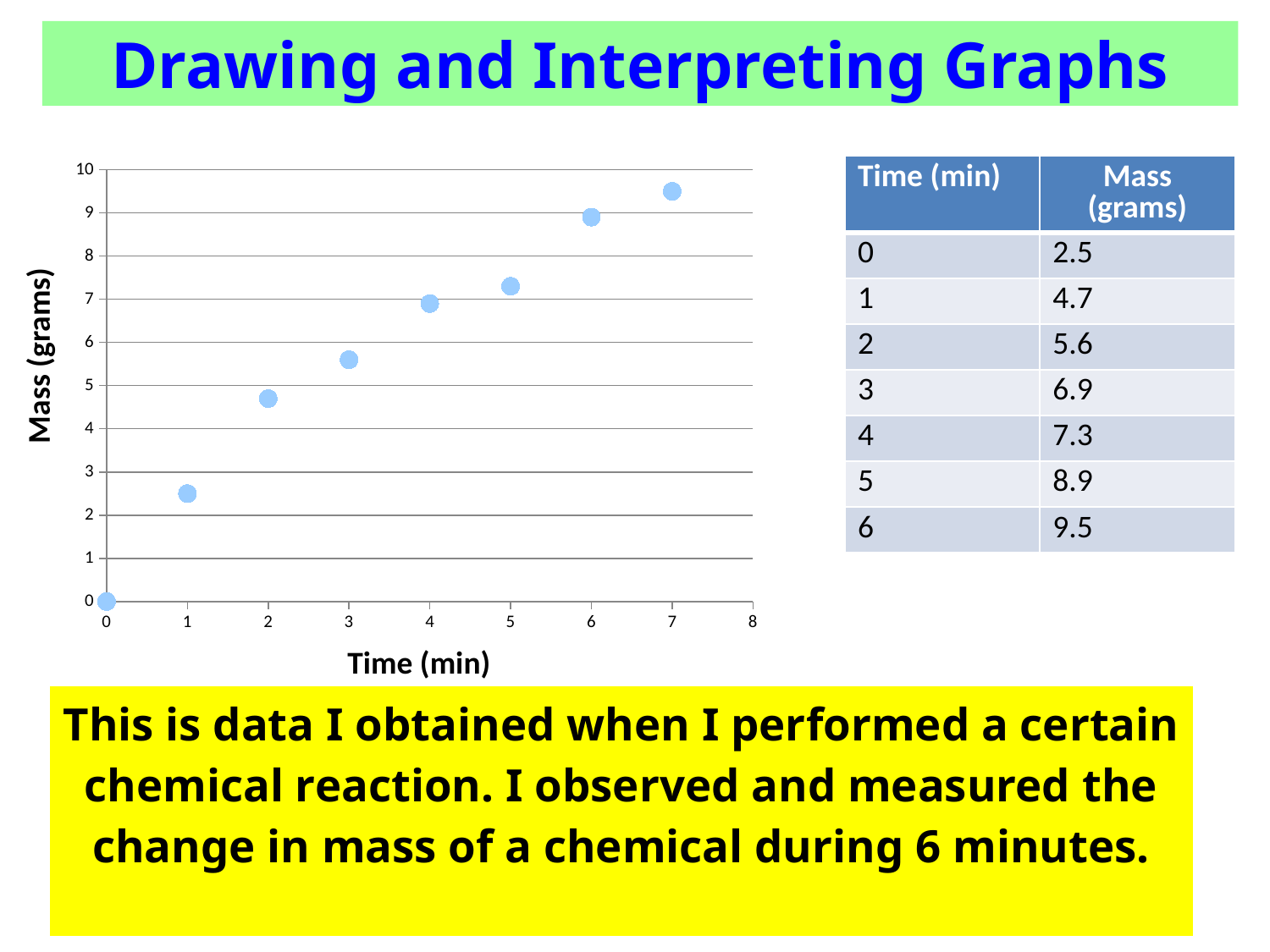
How many data points are plotted on the chart? 8 What kind of chart is shown on the slide? Scatter chart Do the plotted values rise or fall as time increases along the x axis? Rise Is the plotted mass at time 6 min greater or less than 8 grams? greater Is the plotted mass at time 5 min greater or less than 8 grams? less At which time (min) is the lowest point on the chart? 0 What is the title of the chart's vertical axis? Mass (grams) Is the plotted mass at time 3 min greater or less than 5 grams? greater At which time (min) is the highest point on the chart? 7 Which has the larger plotted mass on the chart: time 2 min or time 6 min? Time 6 min What is the title of the chart's horizontal axis? Time (min)